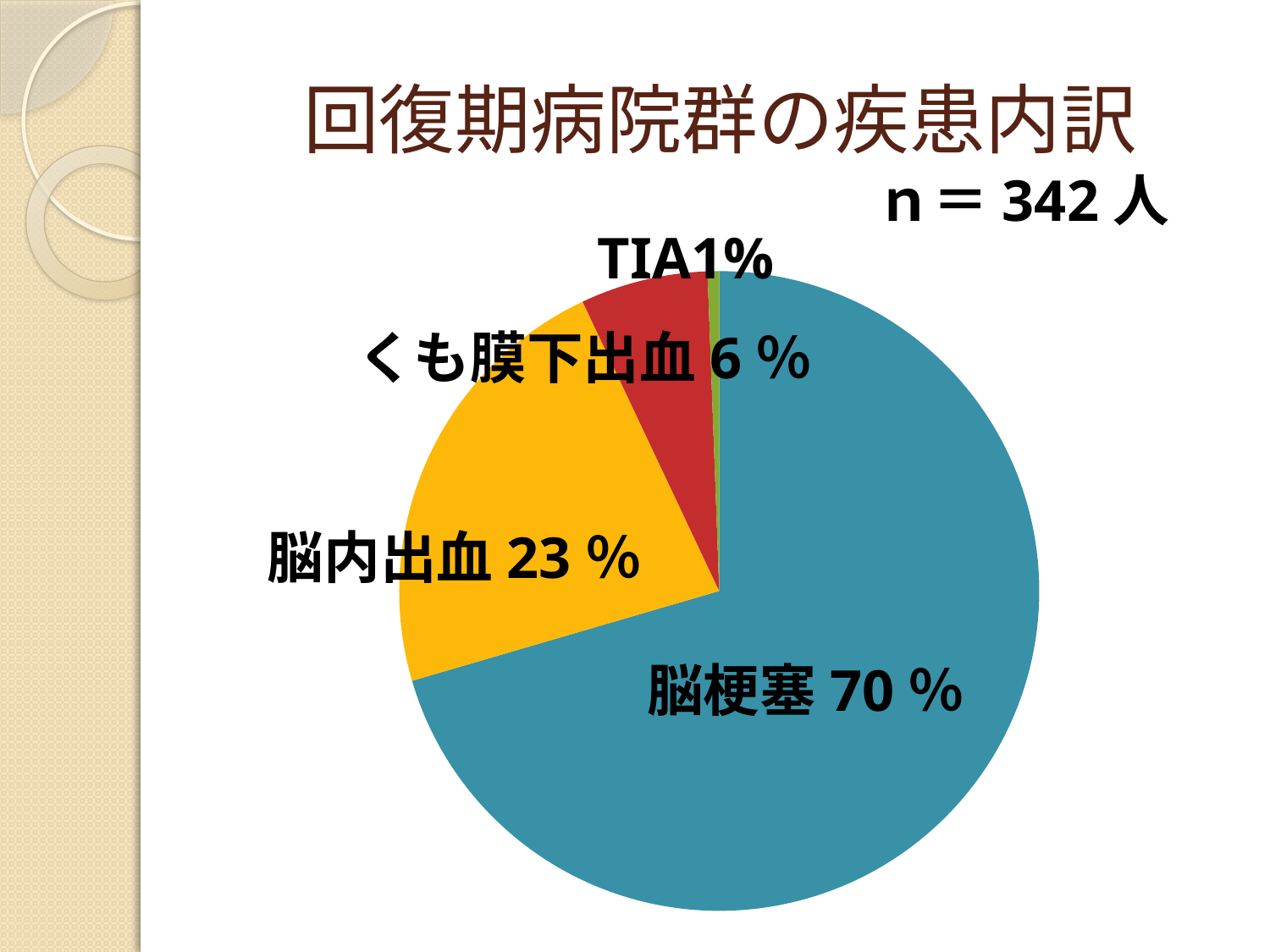
What is the sample size (n) shown on the slide? 342 人 What share of the pie does 脳内出血 account for? 23 % Which category has the largest slice of the pie? 脳梗塞 What share of the pie does 脳梗塞 account for? 70 % Which is larger, the share for 脳内出血 or the share for くも膜下出血? 脳内出血 What is the title of the chart on the slide? 回復期病院群の疾患内訳 What kind of chart is shown on the slide? pie chart What share of the pie does くも膜下出血 account for? 6 % Which category has the smallest slice of the pie? TIA What is the difference in percentage points between 脳梗塞 and 脳内出血? 47 How many categories are shown in the pie chart? 4